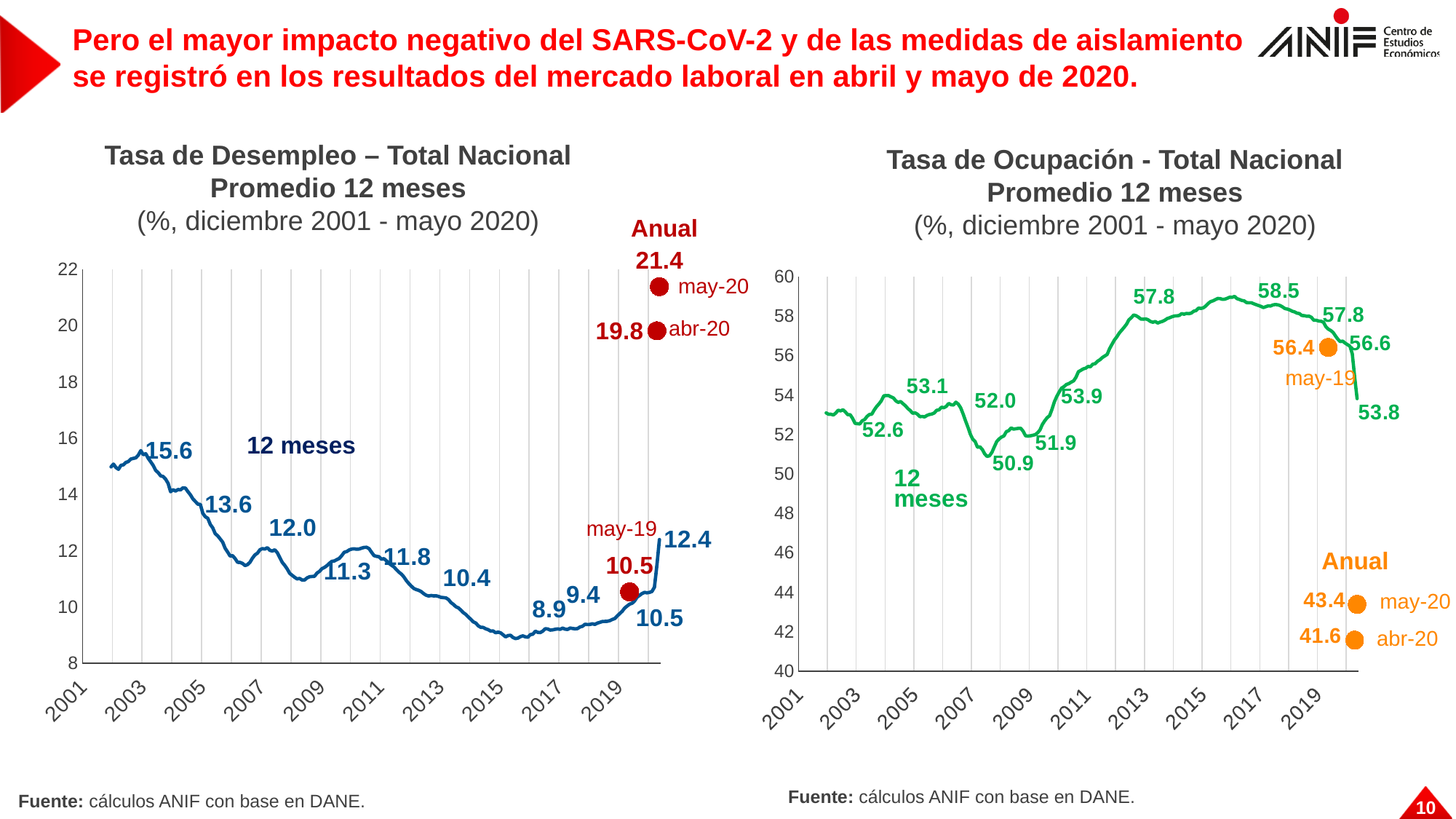
On the Tasa de Ocupación chart, what is the annual (Anual) value labelled for may-20? 43.4 What kind of chart is the Tasa de Desempleo chart? line chart On the Tasa de Ocupación chart, what is the difference between the annual values for may-20 and abr-20? 1.8 On the Tasa de Desempleo chart, what is the annual (Anual) value labelled for may-20? 21.4 On the Tasa de Ocupación chart, what is the lowest value labelled on the 12-month average line? 50.9 On the Tasa de Desempleo chart, what is the annual (Anual) value labelled for abr-20? 19.8 On the Tasa de Desempleo chart, what is the difference between the annual values for may-20 and abr-20? 1.6 On the Tasa de Ocupación chart, what is the annual (Anual) value labelled for abr-20? 41.6 On the Tasa de Desempleo chart, what is the last value labelled at the end of the 12-month average line? 12.4 On the Tasa de Ocupación chart, what is the highest value labelled on the 12-month average line? 58.5 On the Tasa de Ocupación chart, what is the value labelled at may-19? 56.4 On the Tasa de Desempleo chart, what is the 12-month average value labelled at may-19? 10.5